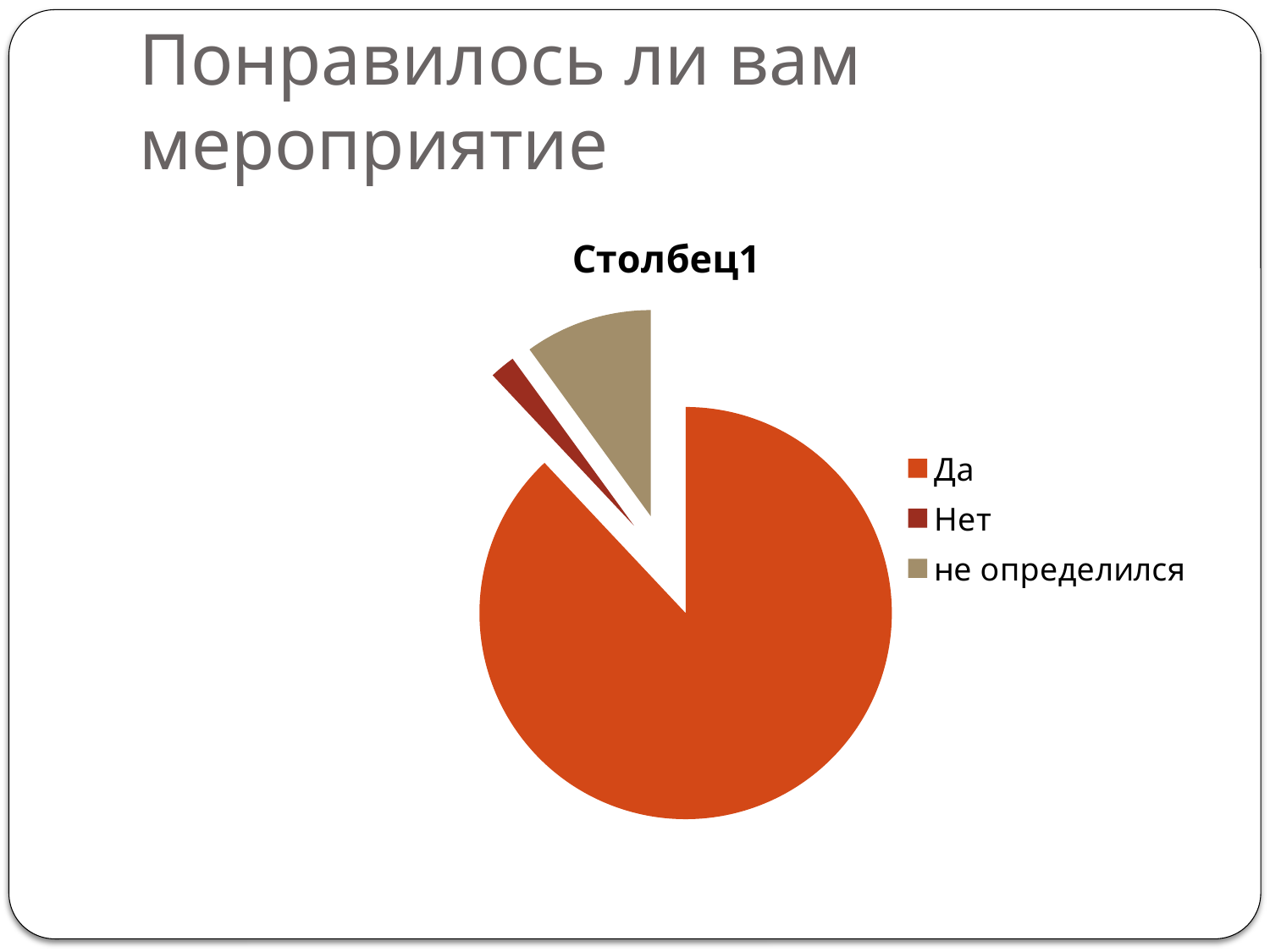
What kind of chart is shown on the slide? pie chart Which category has the smallest slice of the pie? Нет What are the legend entries of the chart? Да, Нет, не определился Which category has the largest slice of the pie? Да How many slices does the pie chart have? 3 Which slice is larger, Да or не определился? Да What is the title of the chart? Столбец1 Which slice is larger, Нет or не определился? не определился Which category is shown in orange? Да